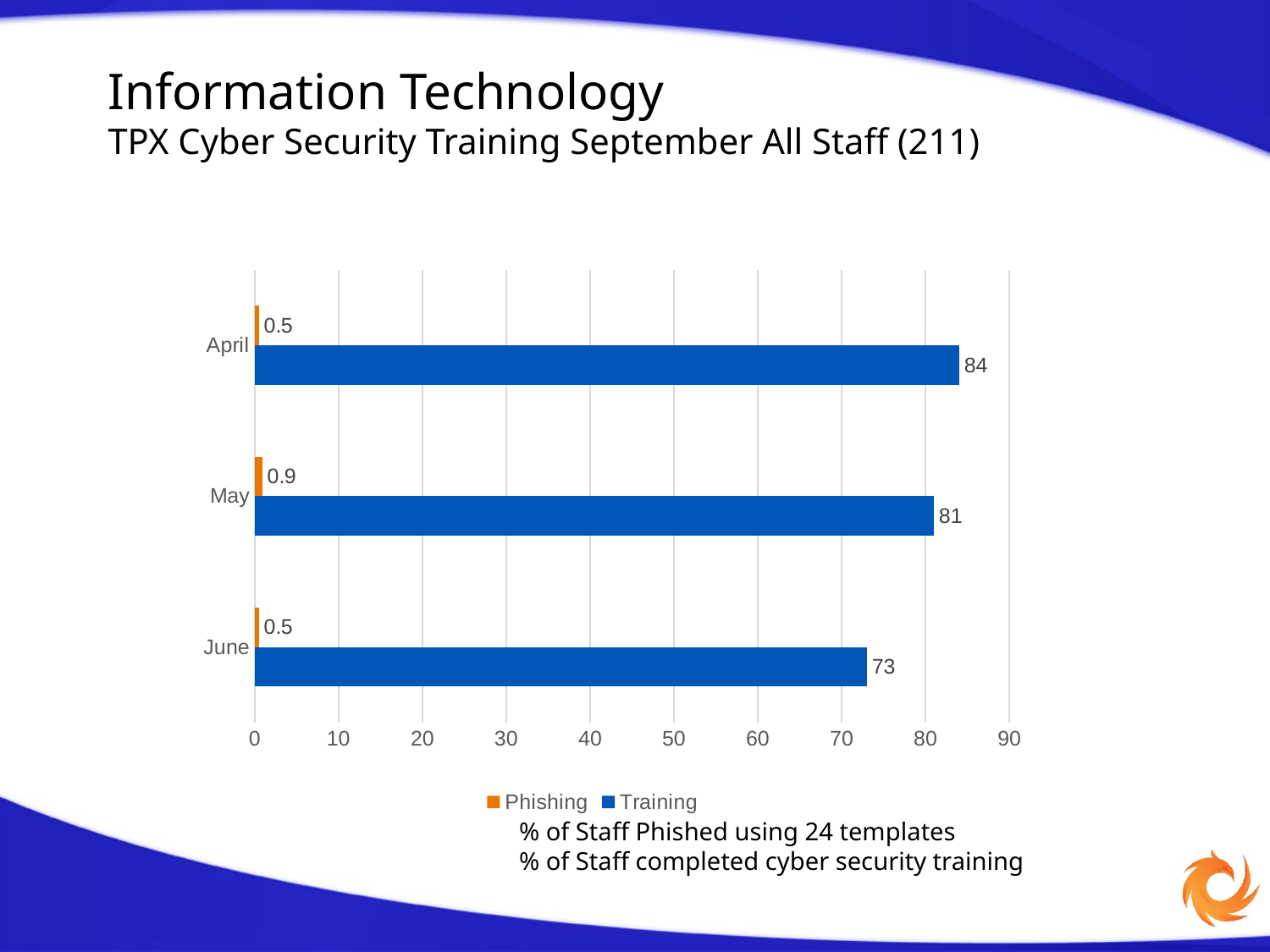
Which month has the highest Phishing value? May Is the Training value for May greater or less than 80? greater What is the Training value for April? 84 How many series does the legend list? 2 What is the Training value for June? 73 Which month has the lowest Training value? June What is the difference between the Training values for April and June? 11 Is the Training value for May larger than the Training value for June? Yes What kind of chart is shown on the slide? Bar chart How many months are shown on the chart? 3 Which month has the highest Training value? April What is the Phishing value for May? 0.9